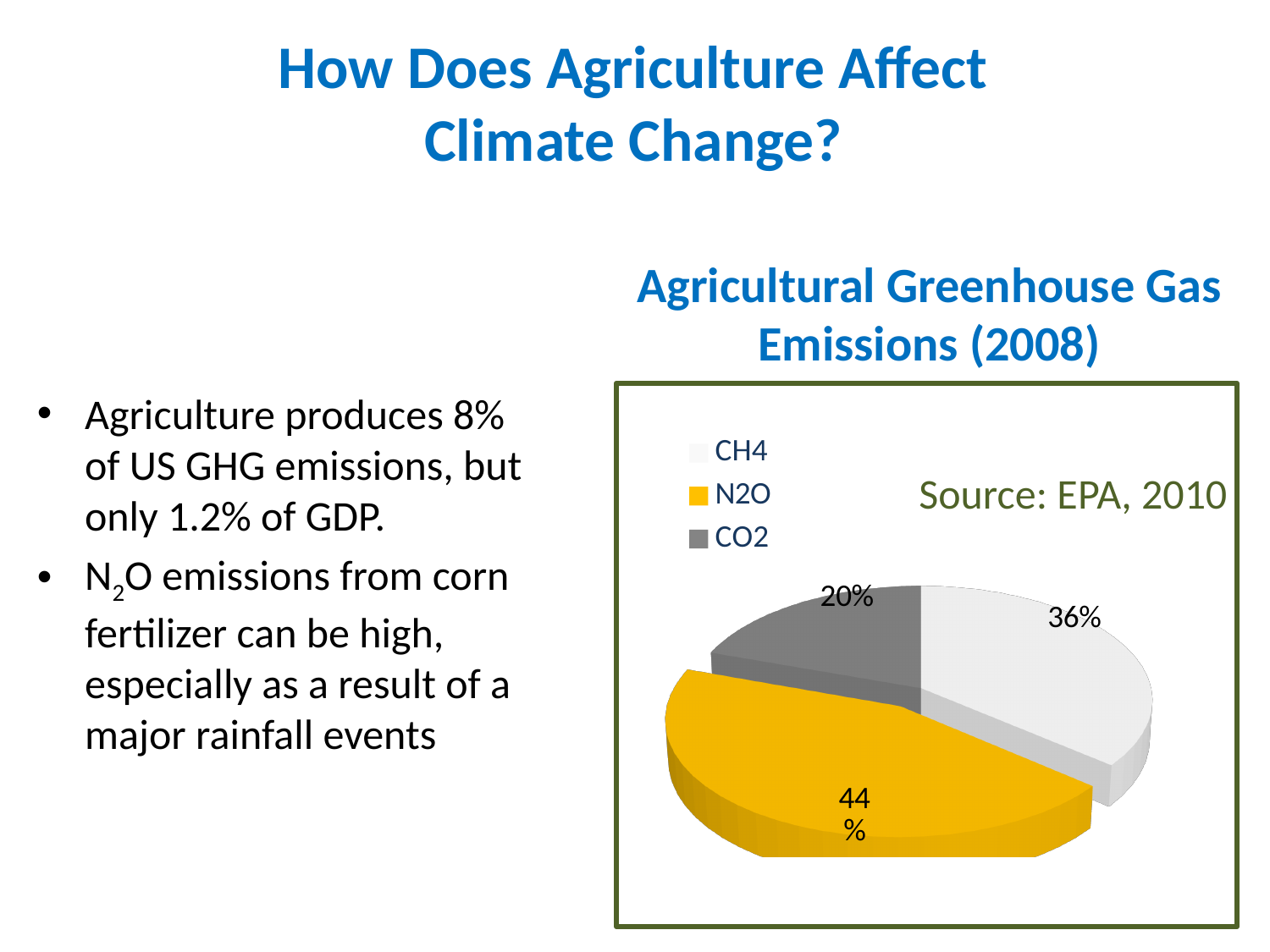
How many slices does the pie chart have? 3 Which gas has the largest share of agricultural greenhouse gas emissions? N2O What share of agricultural greenhouse gas emissions is CH4? 36% What colour is the N2O slice in the pie chart? yellow What share of agricultural greenhouse gas emissions is CO2? 20% How many percentage points larger is the N2O share than the CO2 share? 24 What kind of chart is shown on the slide? pie chart What share of agricultural greenhouse gas emissions is N2O? 44% What is the title of the pie chart? Agricultural Greenhouse Gas Emissions (2008) Which gas has the smallest share of agricultural greenhouse gas emissions? CO2 Which has a larger share of emissions, CH4 or CO2? CH4 How many percentage points larger is the N2O share than the CH4 share? 8